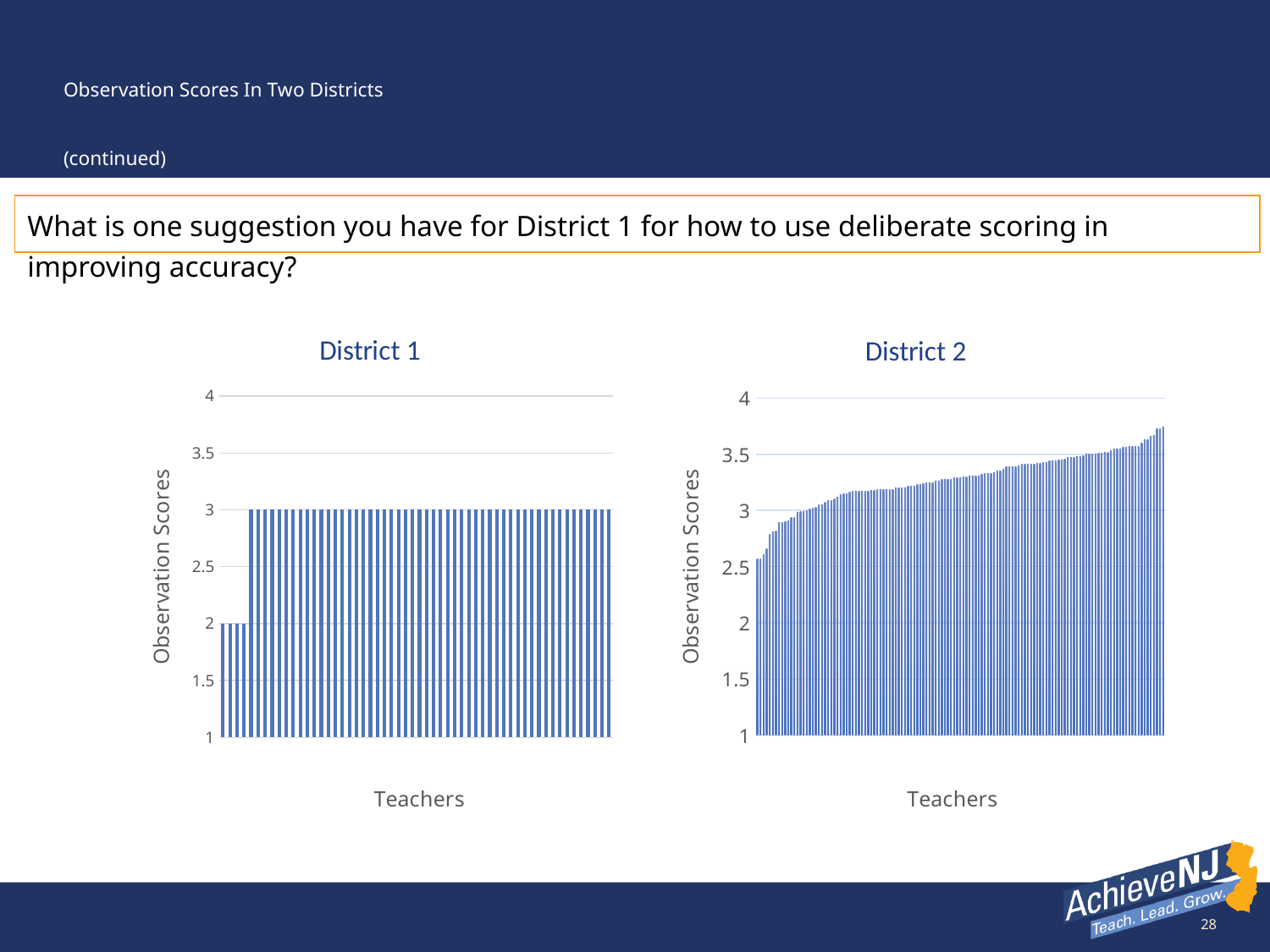
In the District 1 chart, is the value of the tallest bar greater or less than 3.5? less What is the y-axis title on the District 1 chart? Observation Scores In the District 2 chart, is the value of the shortest bar greater or less than 3? less In the District 1 chart, what value do the shortest bars reach on the y axis? 2 What kind of chart is the District 2 chart? bar chart What kind of chart is the District 1 chart? bar chart In the District 1 chart, how many distinct score levels do the bars take? 2 In the District 2 chart, is the value of the tallest bar greater or less than 3.5? greater What is the x-axis title on the District 2 chart? Teachers In the District 2 chart, do the observation scores rise or fall from left to right along the x axis? rise In the District 1 chart, what value do the tallest bars reach on the y axis? 3 Which chart has the higher maximum observation score, District 1 or District 2? District 2